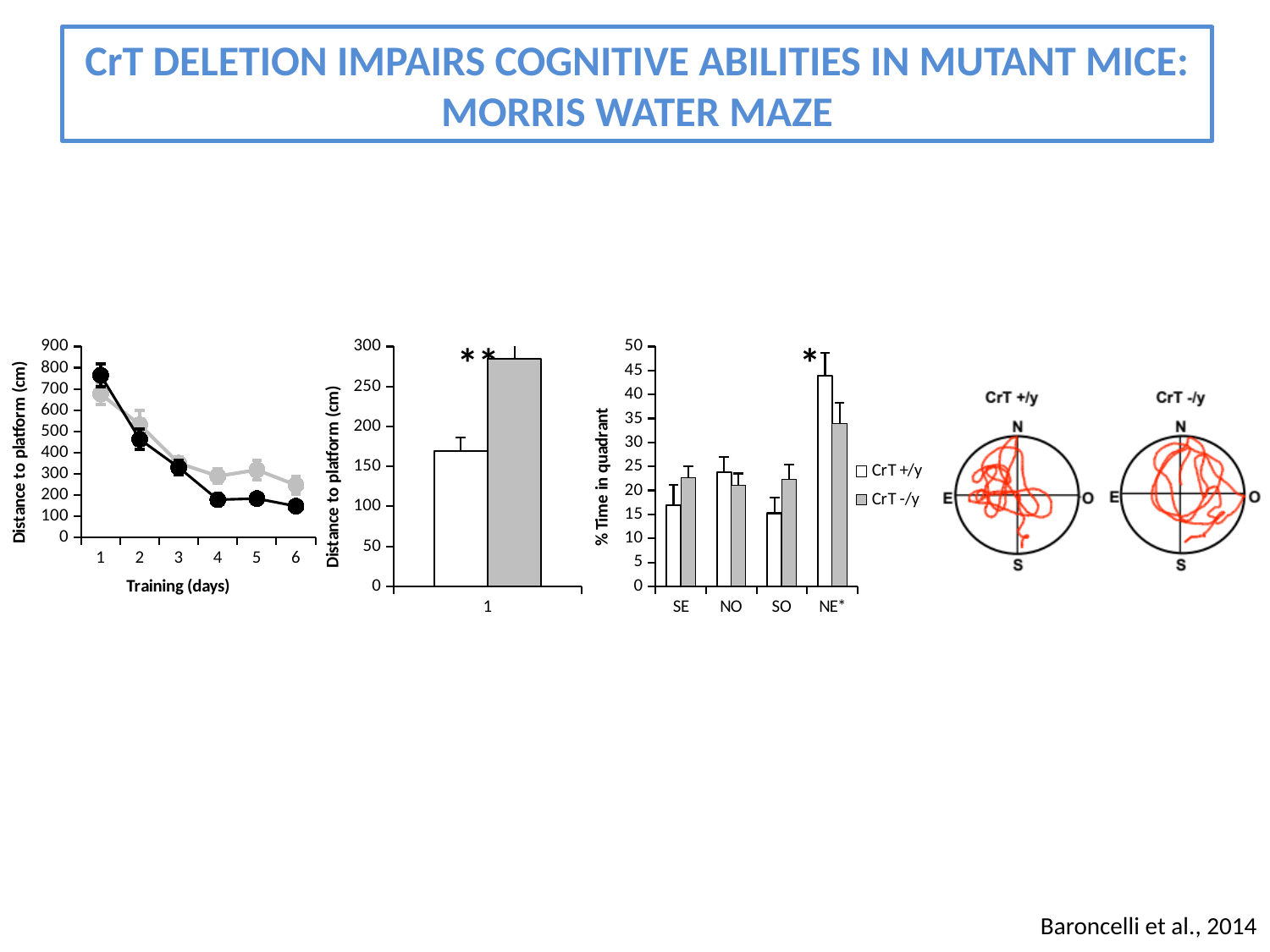
In the leftmost line chart, do the values rise or fall from day 1 to day 6? fall In the chart titled % Time in quadrant, how many series does the legend list? 2 In the middle bar chart, which bar is taller, the white bar or the grey bar? the grey bar In the chart titled % Time in quadrant, how many quadrant categories are shown on the x axis? 4 In the chart titled % Time in quadrant, is the CrT +/y value for NE* greater or less than 40? greater What kind of chart is the middle chart with the y axis Distance to platform (cm) running from 0 to 300? bar chart In the leftmost line chart, is the black series value at day 6 greater or less than 200? less In the leftmost line chart, is the black series value at day 1 greater or less than 700? greater What kind of chart is the leftmost chart with the x axis labelled Training (days)? line chart In the leftmost line chart, how many training days are plotted along the x axis? 6 In the chart titled % Time in quadrant, which quadrant has the highest value for CrT +/y? NE*